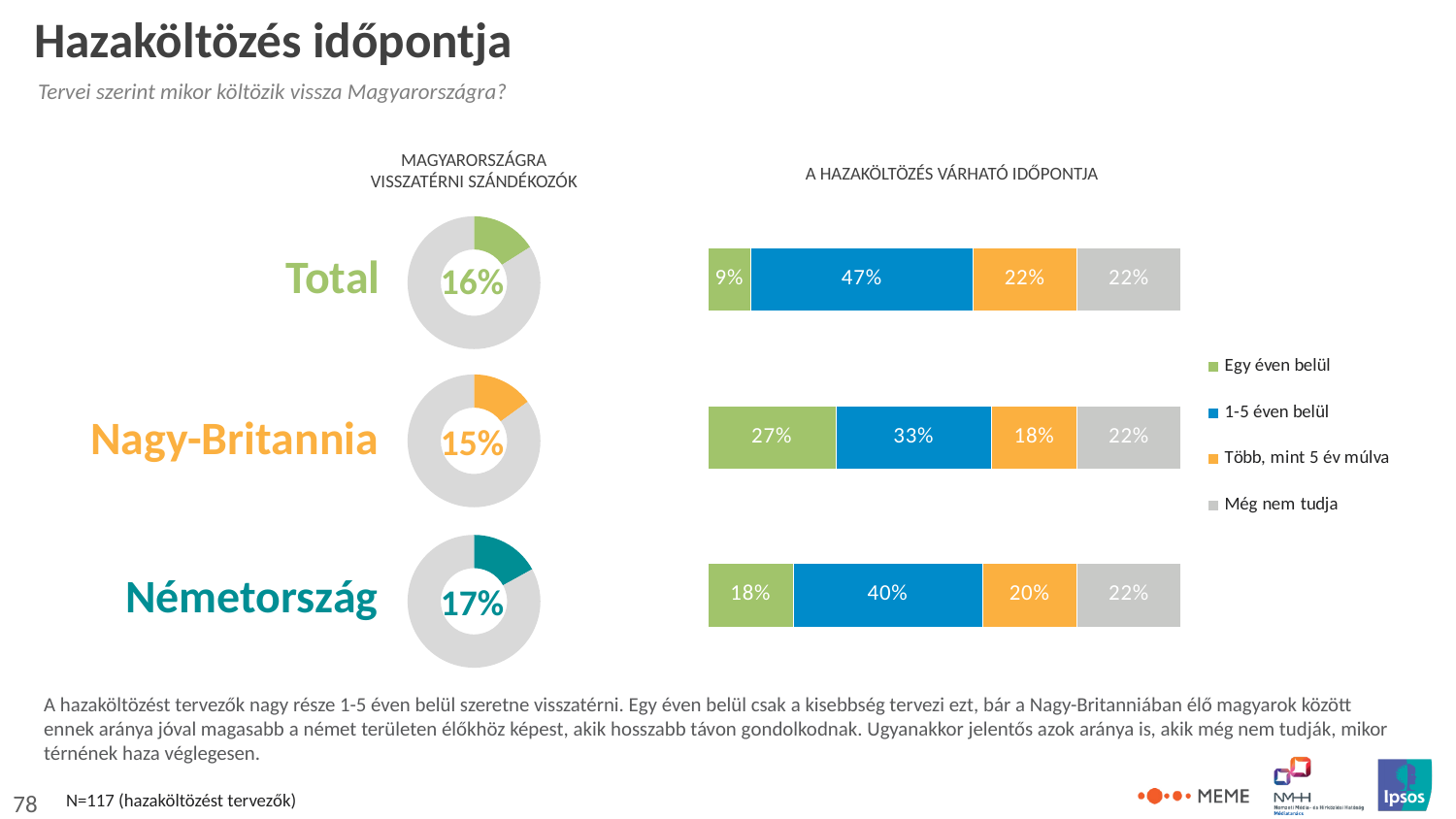
In the 'A hazaköltözés várható időpontja' stacked bar chart, which group has the highest 'Egy éven belül' share? Nagy-Britannia How many series does the legend of the 'A hazaköltözés várható időpontja' stacked bar chart list? 4 In the 'A hazaköltözés várható időpontja' stacked bar chart, which is larger: the '1-5 éven belül' value for Total or for Németország? Total In the 'A hazaköltözés várható időpontja' stacked bar chart, what is the '1-5 éven belül' value for Nagy-Britannia? 33% In the 'Magyarországra visszatérni szándékozók' donut charts, what percentage is shown for Nagy-Britannia? 15% What type of chart is used for 'A hazaköltözés várható időpontja'? Stacked bar chart Among the 'Magyarországra visszatérni szándékozók' donut charts, which group has the lowest percentage? Nagy-Britannia In the 'A hazaköltözés várható időpontja' stacked bar chart, what percentage of the Total bar is 'Egy éven belül'? 9% Among the 'Magyarországra visszatérni szándékozók' donut charts, which group has the highest percentage? Németország In the 'A hazaköltözés várható időpontja' stacked bar chart, what is the 'Több, mint 5 év múlva' value for Németország? 20% In the 'A hazaköltözés várható időpontja' stacked bar chart, what is the difference between the 'Egy éven belül' values for Nagy-Britannia and Németország? 9% In the 'A hazaköltözés várható időpontja' stacked bar chart, what is the 'Még nem tudja' value for Total? 22%